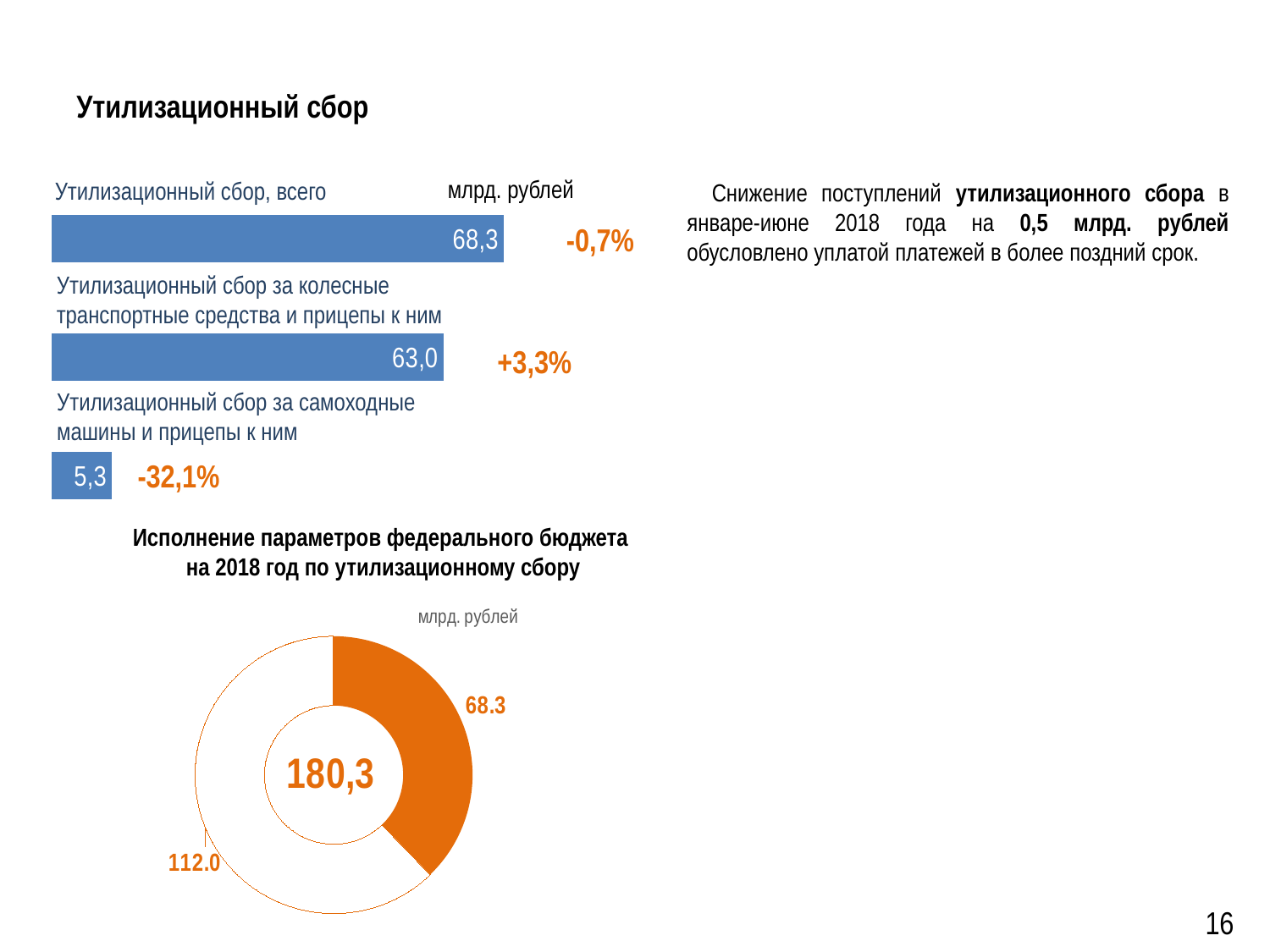
In the bar chart at the top left, what is the value for "Утилизационный сбор за колесные транспортные средства и прицепы к ним"? 63,0 In the chart titled "Исполнение параметров федерального бюджета на 2018 год по утилизационному сбору", what is the value of the orange segment? 68.3 In the bar chart at the top left, what is the value for "Утилизационный сбор, всего"? 68,3 In the bar chart at the top left, what percentage change is shown next to the bar for "Утилизационный сбор, всего"? -0,7% In the bar chart at the top left, what percentage change is shown next to the bar for "Утилизационный сбор за самоходные машины и прицепы к ним"? -32,1% In the bar chart at the top left, what is the difference between the values for "Утилизационный сбор, всего" and "Утилизационный сбор за колесные транспортные средства и прицепы к ним"? 5,3 In the chart titled "Исполнение параметров федерального бюджета на 2018 год по утилизационному сбору", what value is shown in the centre of the donut? 180,3 What kind of chart is shown at the top left of the slide? Bar chart In the chart titled "Исполнение параметров федерального бюджета на 2018 год по утилизационному сбору", which segment is larger, the one labelled 68.3 or the one labelled 112.0? 112.0 In the bar chart at the top left, how many bars are shown? 3 In the bar chart at the top left, which category has the smallest bar? Утилизационный сбор за самоходные машины и прицепы к ним In the bar chart at the top left, what is the value for "Утилизационный сбор за самоходные машины и прицепы к ним"? 5,3